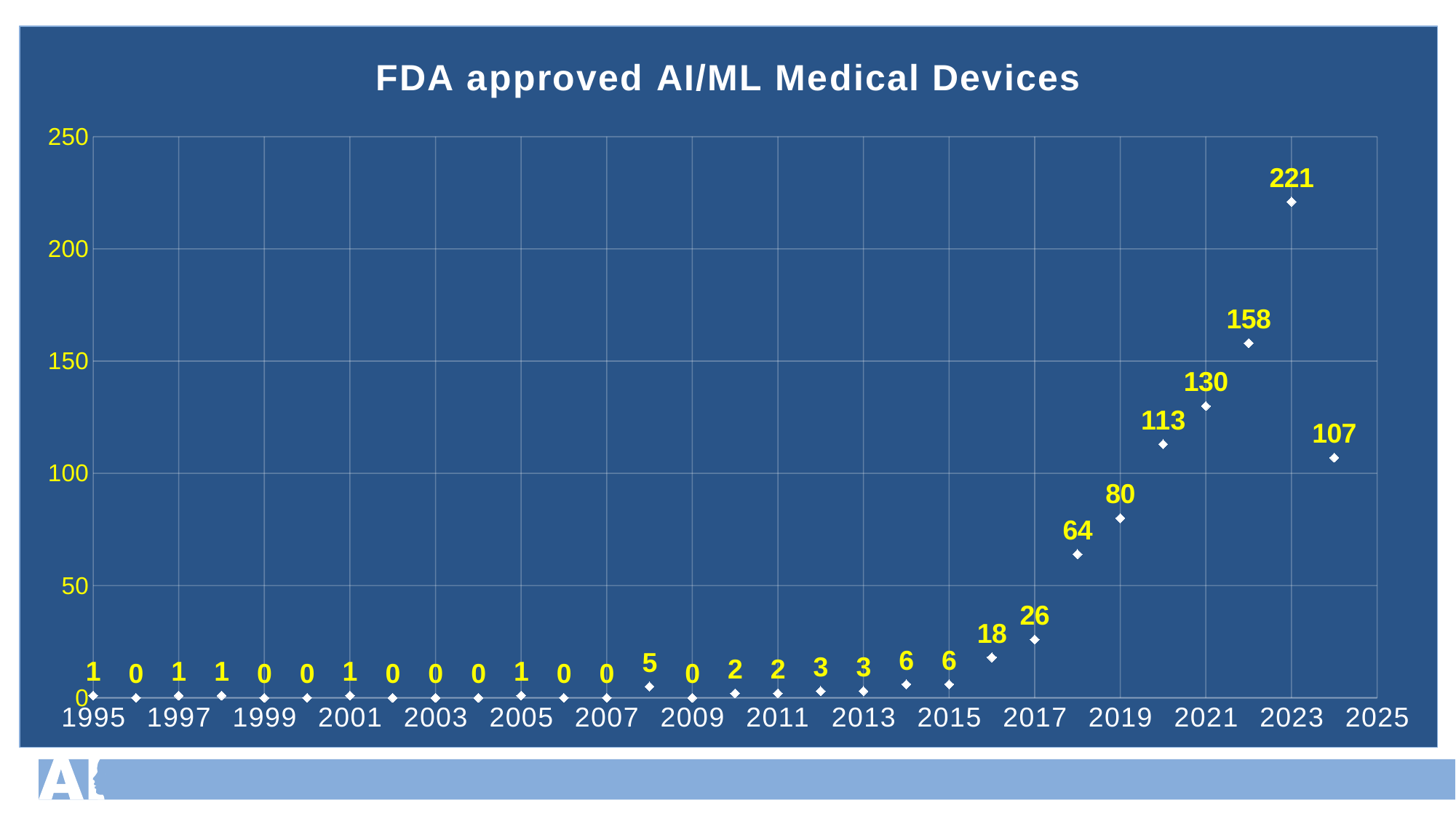
What is the title of the chart? FDA approved AI/ML Medical Devices Which is larger, the value for 2021 or the value for 2024? 2021 What is the value for 2020? 113 How many data points are plotted on the chart? 30 What is the difference between the values for 2023 and 2022? 63 What is the value for 2024? 107 What is the difference between the values for 2019 and 2018? 16 What is the value for 2018? 64 Is the value for 2022 greater or less than 150? greater What is the value for 2023? 221 Which year has the highest value? 2023 What kind of chart is shown on the slide? scatter chart